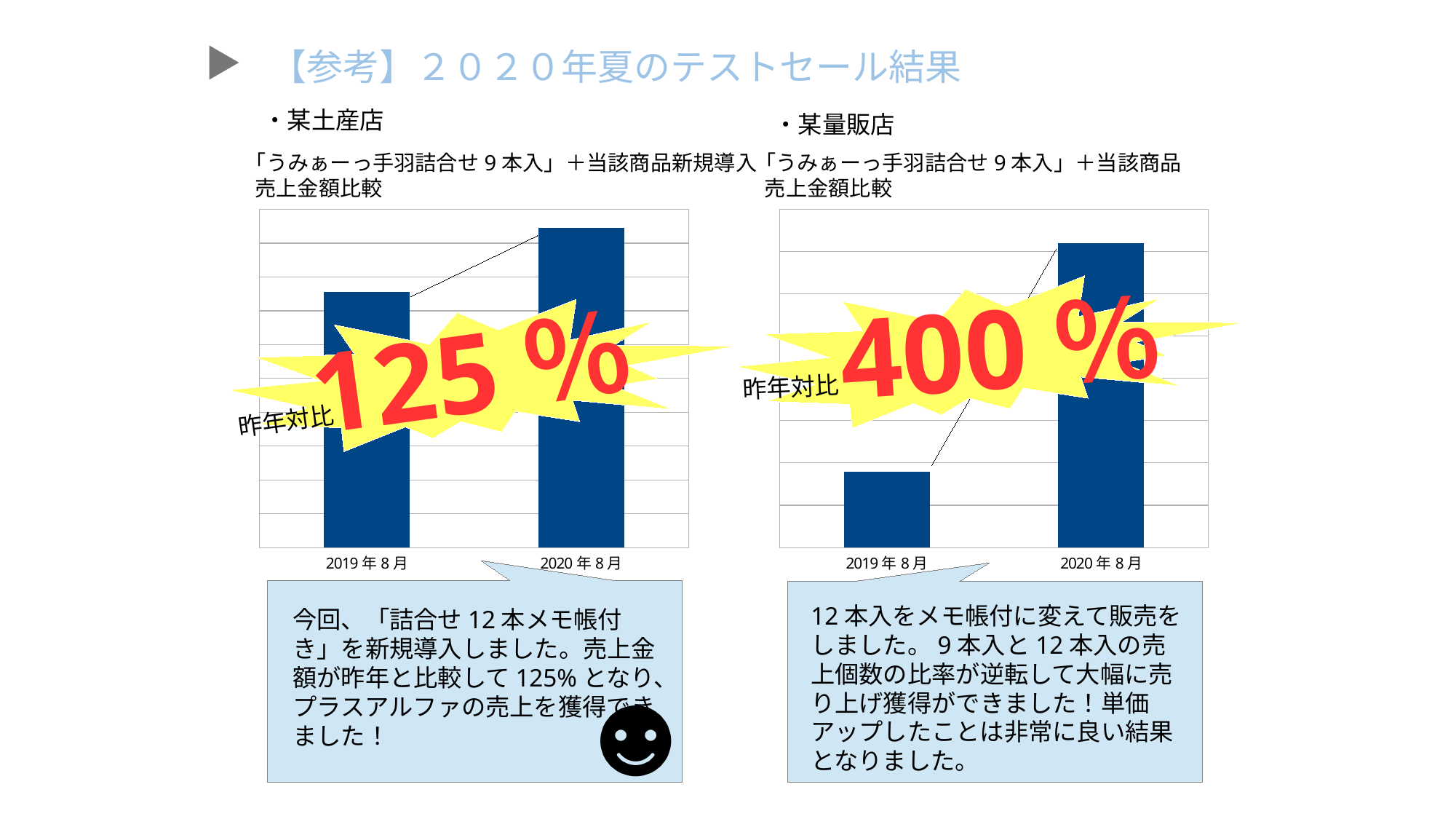
In the left chart (某土産店), do the bars rise or fall from 2019年8月 to 2020年8月? rise In the right chart (某量販店), how many categories are on the x axis? 2 What year-on-year percentage (昨年対比) is printed on the left chart (某土産店)? 125％ In the right chart (某量販店), which category has the tallest bar? 2020年8月 What kind of chart is shown under 某土産店 on the left? bar chart In the right chart (某量販店), which category has the shorter bar? 2019年8月 In the left chart (某土産店), which category has the taller bar, 2019年8月 or 2020年8月? 2020年8月 In the right chart (某量販店), do the bars rise or fall from 2019年8月 to 2020年8月? rise What kind of chart is shown under 某量販店 on the right? bar chart In the left chart (某土産店), how many bars are plotted? 2 What year-on-year percentage (昨年対比) is printed on the right chart (某量販店)? 400％